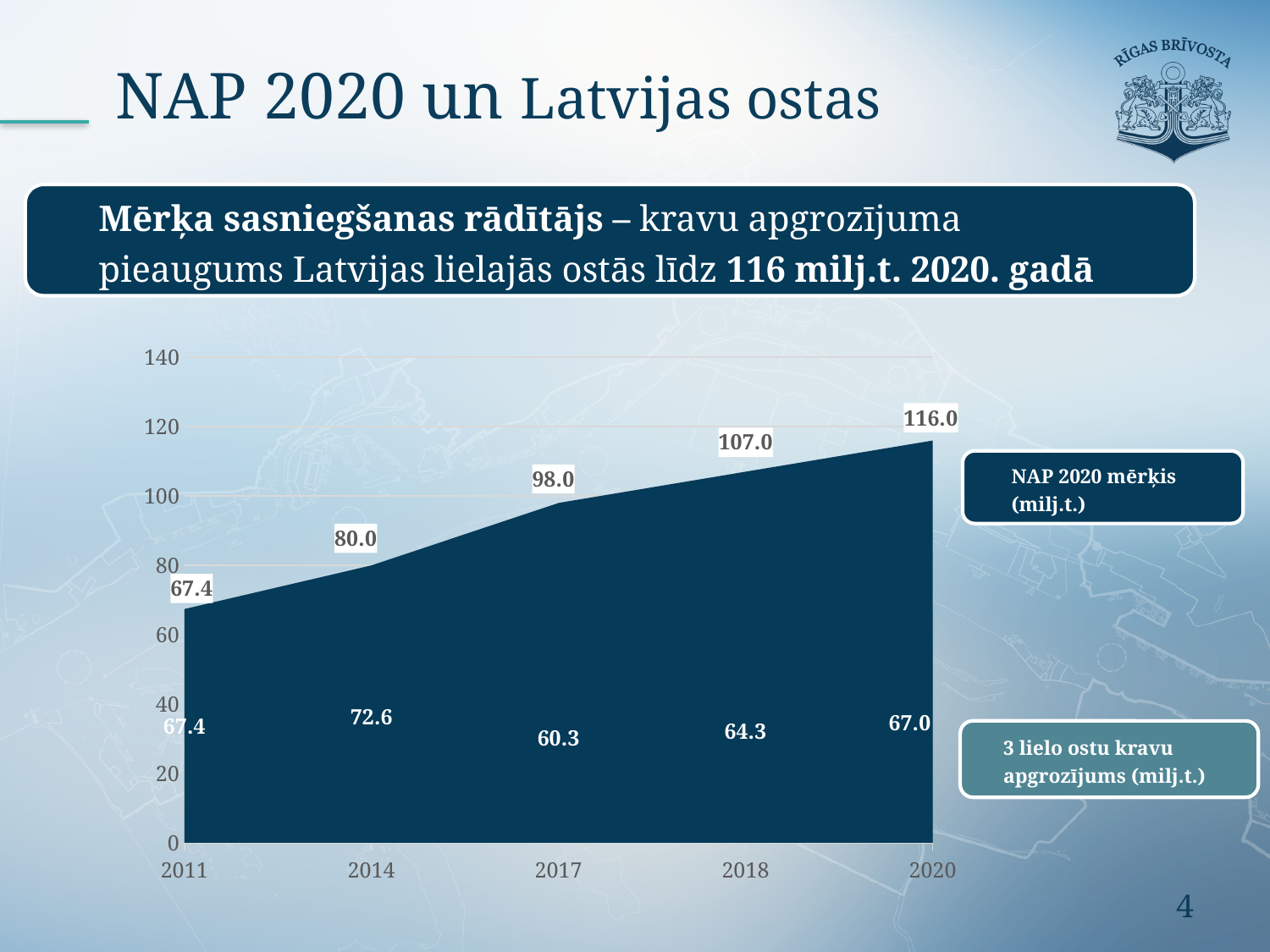
Does the NAP 2020 mērķis (milj.t.) series rise or fall from 2011 to 2020? Rise What is the NAP 2020 mērķis (milj.t.) value for 2020? 116.0 What kind of chart is shown on the slide? Area chart How many years are shown on the x axis of the chart? 5 What is the 3 lielo ostu kravu apgrozījums (milj.t.) value for 2017? 60.3 Which is larger in 2018: the NAP 2020 mērķis value or the 3 lielo ostu kravu apgrozījums value? NAP 2020 mērķis What is the 3 lielo ostu kravu apgrozījums (milj.t.) value for 2018? 64.3 In which year is the 3 lielo ostu kravu apgrozījums (milj.t.) value the lowest? 2017 What is the difference between the NAP 2020 mērķis and the 3 lielo ostu kravu apgrozījums values in 2020? 49.0 How many series does the chart show? 2 In which year is the NAP 2020 mērķis (milj.t.) value the highest? 2020 What is the NAP 2020 mērķis (milj.t.) value for 2014? 80.0